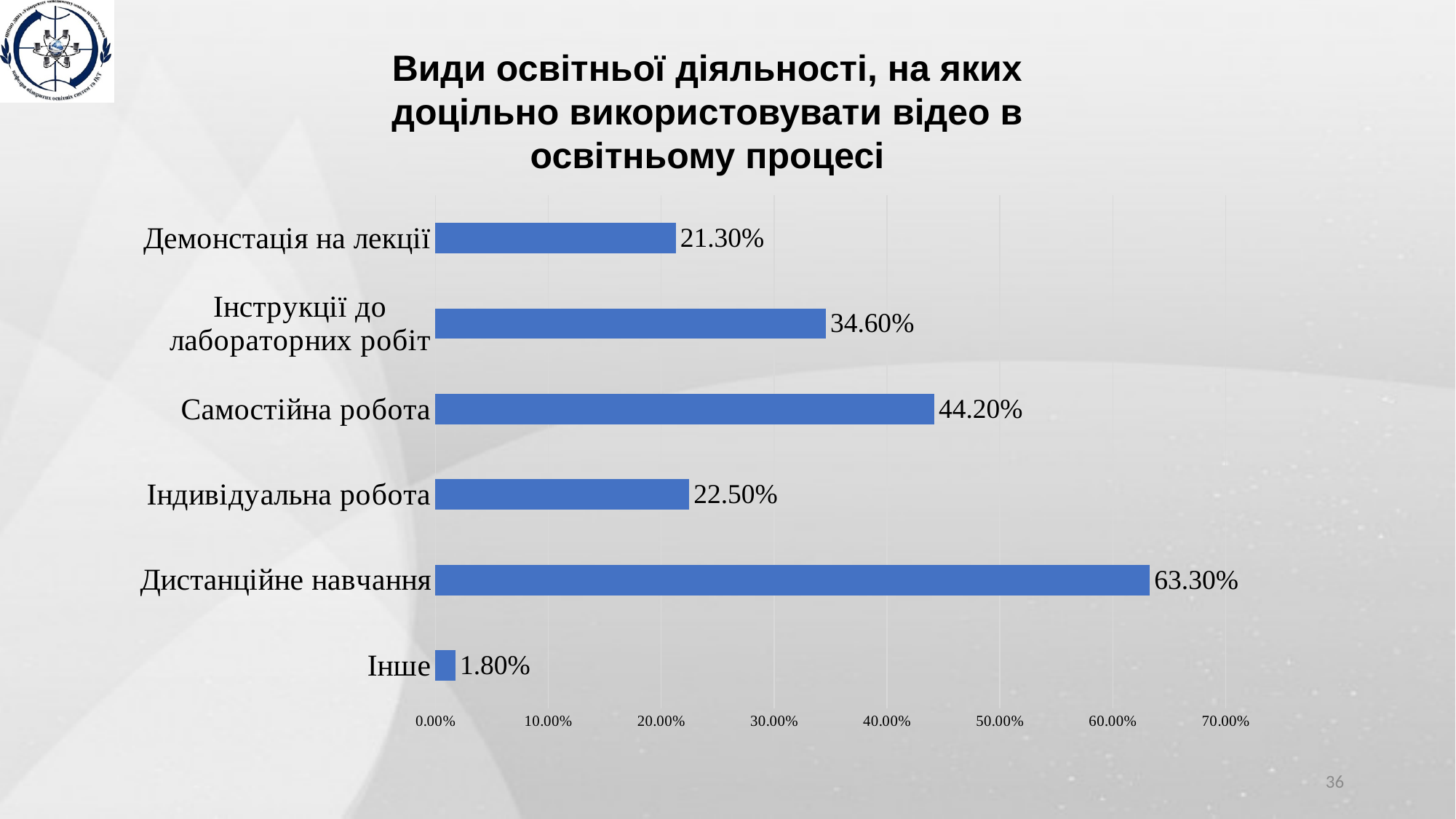
Which is larger, the value for Самостійна робота or the value for Інструкції до лабораторних робіт? Самостійна робота What is the value for Дистанційне навчання? 63.30% What kind of chart is shown on the slide? bar chart What is the difference between the values for Індивідуальна робота and Демонстація на лекції? 1.20% What is the title of the chart? Види освітньої діяльності, на яких доцільно використовувати відео в освітньому процесі How many categories are shown in the chart? 6 What is the value for Інше? 1.80% Is the value for Самостійна робота greater or less than 40.00%? greater Which category has the lowest value? Інше What is the value for Інструкції до лабораторних робіт? 34.60% Which category has the highest value? Дистанційне навчання What is the difference between the values for Дистанційне навчання and Самостійна робота? 19.10%